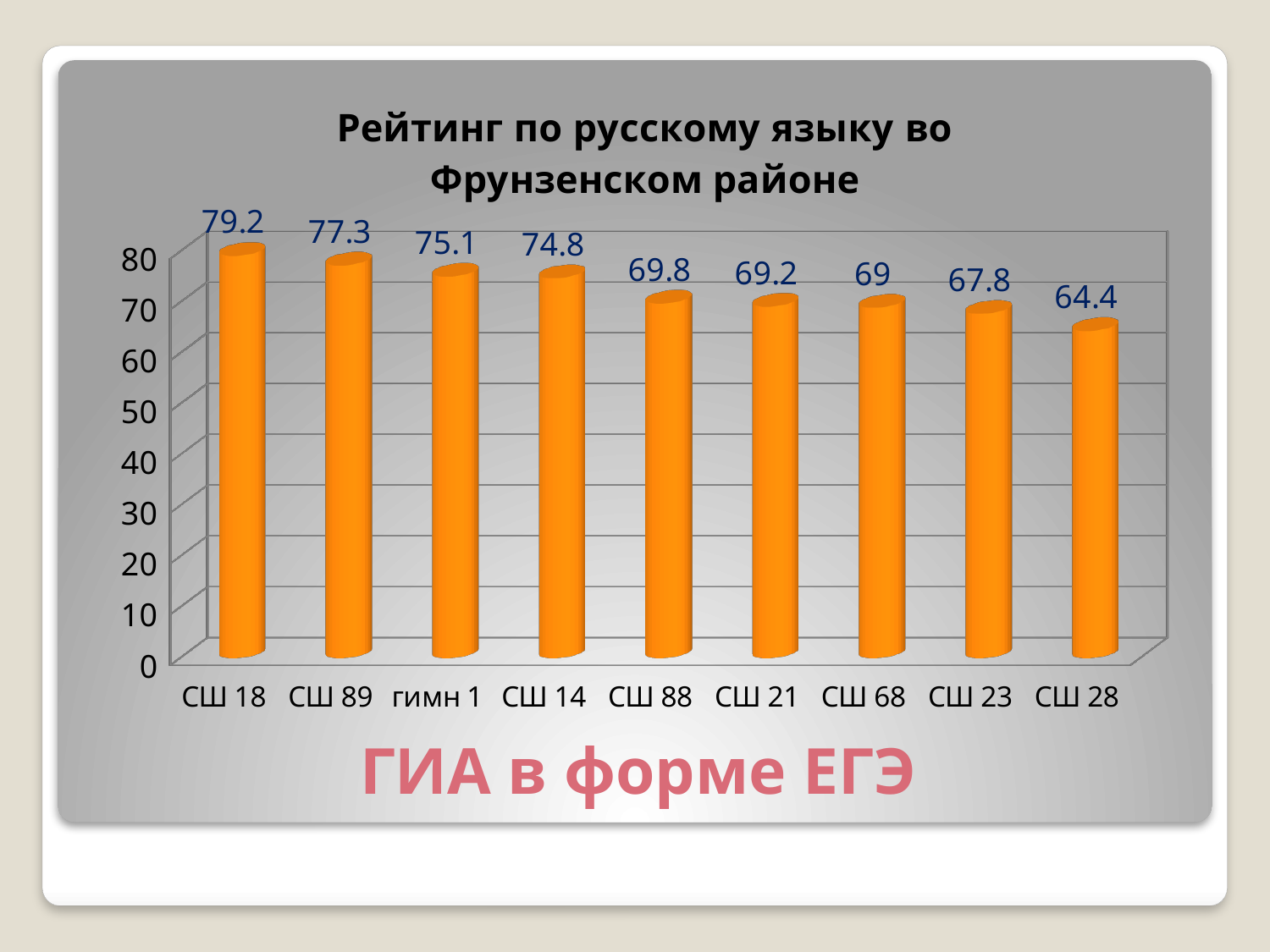
What kind of chart is this? bar chart What is the value for СШ 18? 79.2 Which category has the highest value? СШ 18 What is the title of the chart? Рейтинг по русскому языку во Фрунзенском районе What is the difference between the values for СШ 18 and СШ 28? 14.8 What is the difference between the values for СШ 89 and СШ 14? 2.5 Which is larger, the value for СШ 88 or the value for СШ 23? СШ 88 Which category has the lowest value? СШ 28 What is the value for СШ 28? 64.4 How many categories are shown on the chart? 9 What is the value for СШ 68? 69 What is the value for гимн 1? 75.1